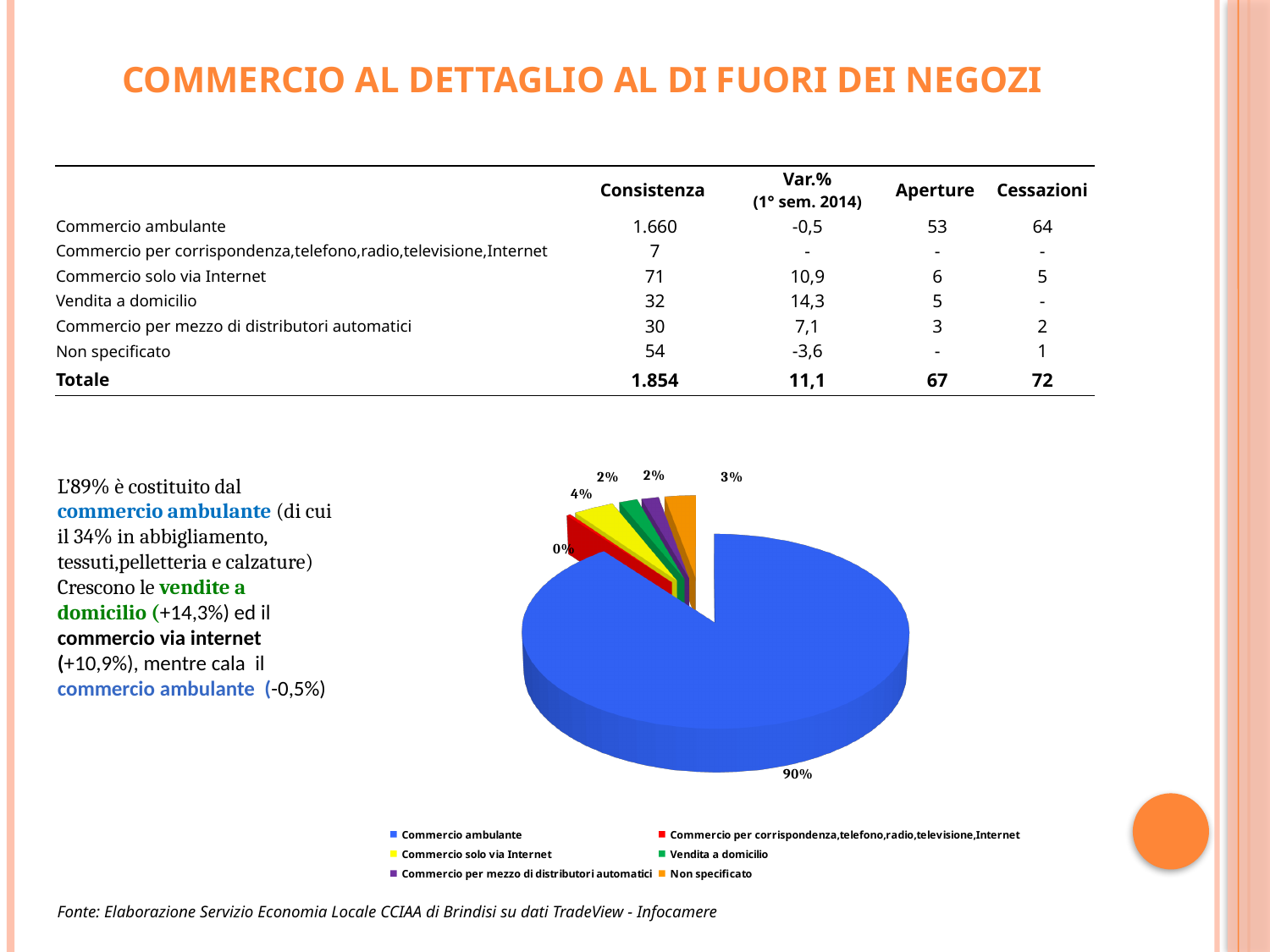
What share of the pie does Commercio ambulante represent? 90% What share of the pie does Non specificato represent? 3% What share of the pie does Vendita a domicilio represent? 2% What colour is the Commercio ambulante slice in the pie chart? blue What is the difference in percentage points between the Commercio ambulante slice and the Non specificato slice? 87% How many slices does the pie chart have? 6 Which category has the largest slice of the pie? Commercio ambulante How many entries does the legend of the pie chart list? 6 What kind of chart is shown on the slide? pie chart Which slice is larger: Commercio solo via Internet or Non specificato? Commercio solo via Internet